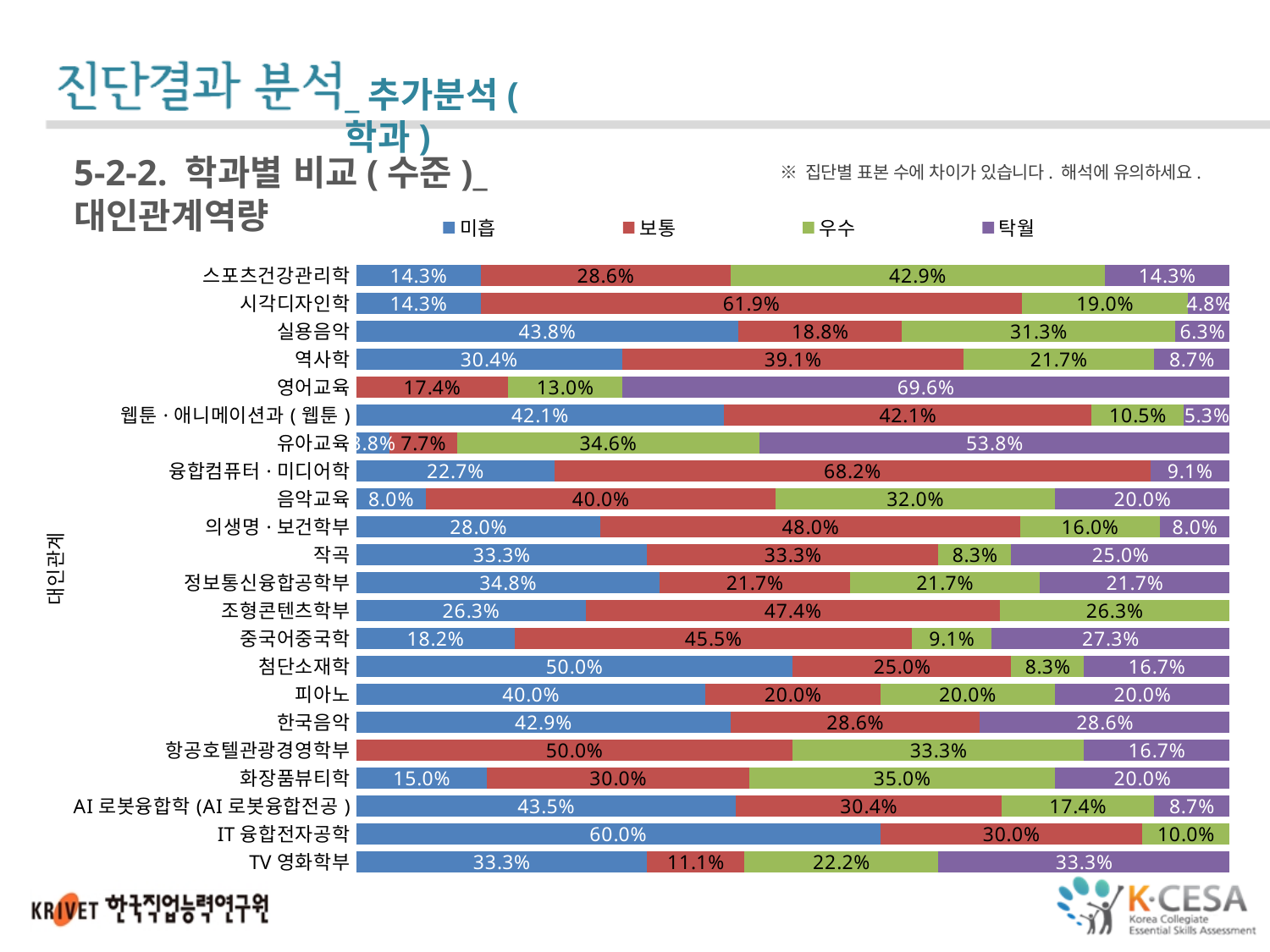
For 실용음악, which is larger: the 미흡 value or the 우수 value? 미흡 What is the 탁월 value for 영어교육? 69.6% Which department has the highest 탁월 value? 영어교육 What is the 미흡 value for IT 융합전자공학? 60.0% What is the difference between the 보통 and 우수 values for 시각디자인학? 42.9% What is the 보통 value for 시각디자인학? 61.9% Which department has the highest 미흡 value? IT 융합전자공학 How many series does the legend list? 4 Which legend entry is shown in blue? 미흡 How many departments (categories) are plotted in the chart? 22 What is the 우수 value for 스포츠건강관리학? 42.9% What kind of chart is shown on the slide? bar chart